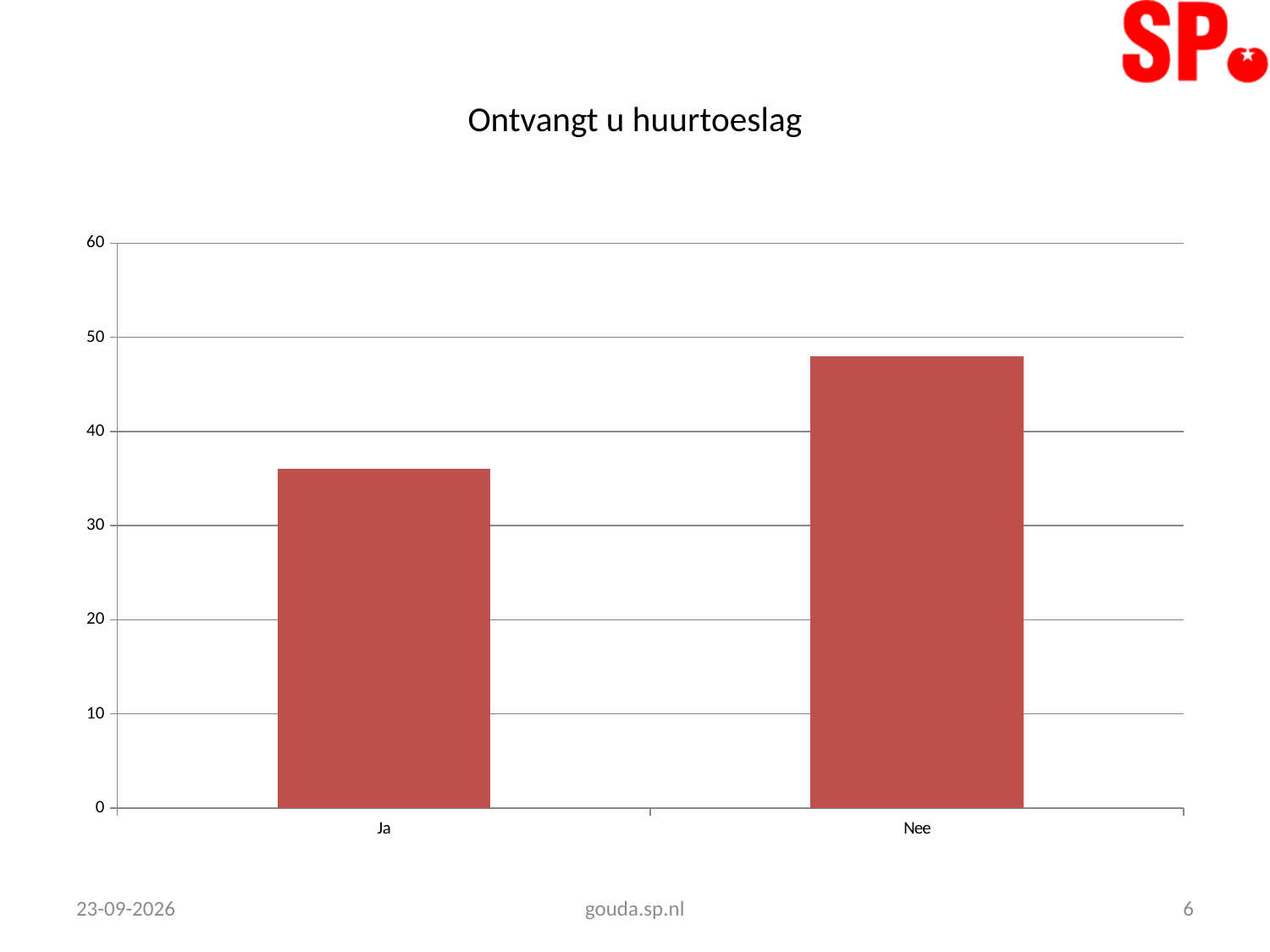
Which is larger, the value for Ja or the value for Nee? Nee Is the value for Ja greater or less than 40? less How many categories are shown on the x axis of the chart? 2 Is the value for Nee greater or less than 40? greater Which category has the highest value in the chart? Nee What colour are the bars in the chart? red Do the values rise or fall going from Ja to Nee along the x axis? rise What is the title of the chart? Ontvangt u huurtoeslag What kind of chart is shown on the slide? bar chart Which category has the lowest value in the chart? Ja Is the value for Ja greater or less than 30? greater